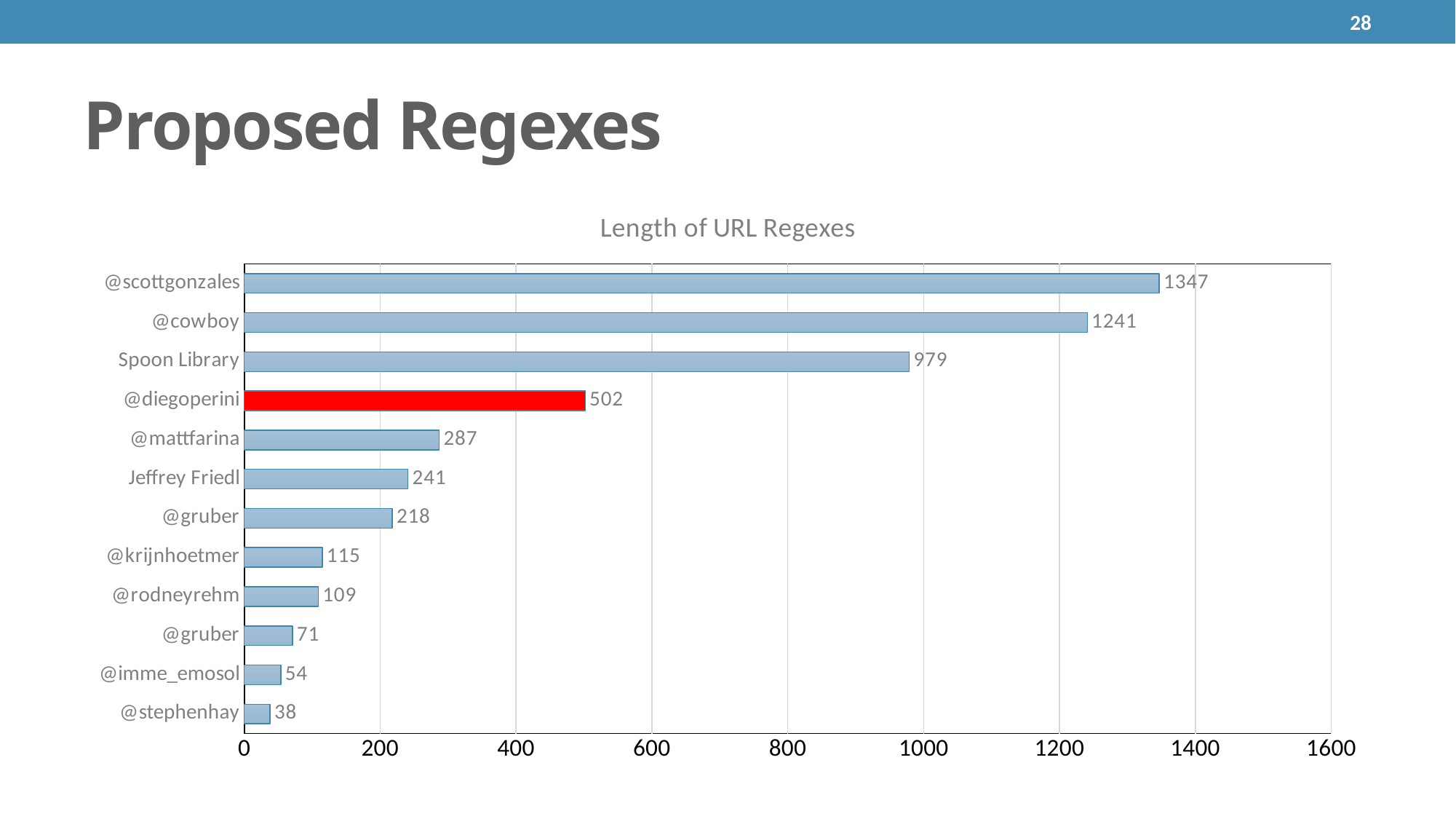
What is the difference between the values for @scottgonzales and @cowboy? 106 What is the value for @imme_emosol? 54 Which bar is coloured red? @diegoperini What is the value for @diegoperini? 502 Is the value for @cowboy greater or less than 1200? greater What is the value for @scottgonzales? 1347 Which is larger, the value for @mattfarina or the value for Jeffrey Friedl? @mattfarina What kind of chart is shown on the slide? Bar chart What is the value for Spoon Library? 979 How many bars are shown in the chart? 12 Which category has the highest value? @scottgonzales Which category has the lowest value? @stephenhay